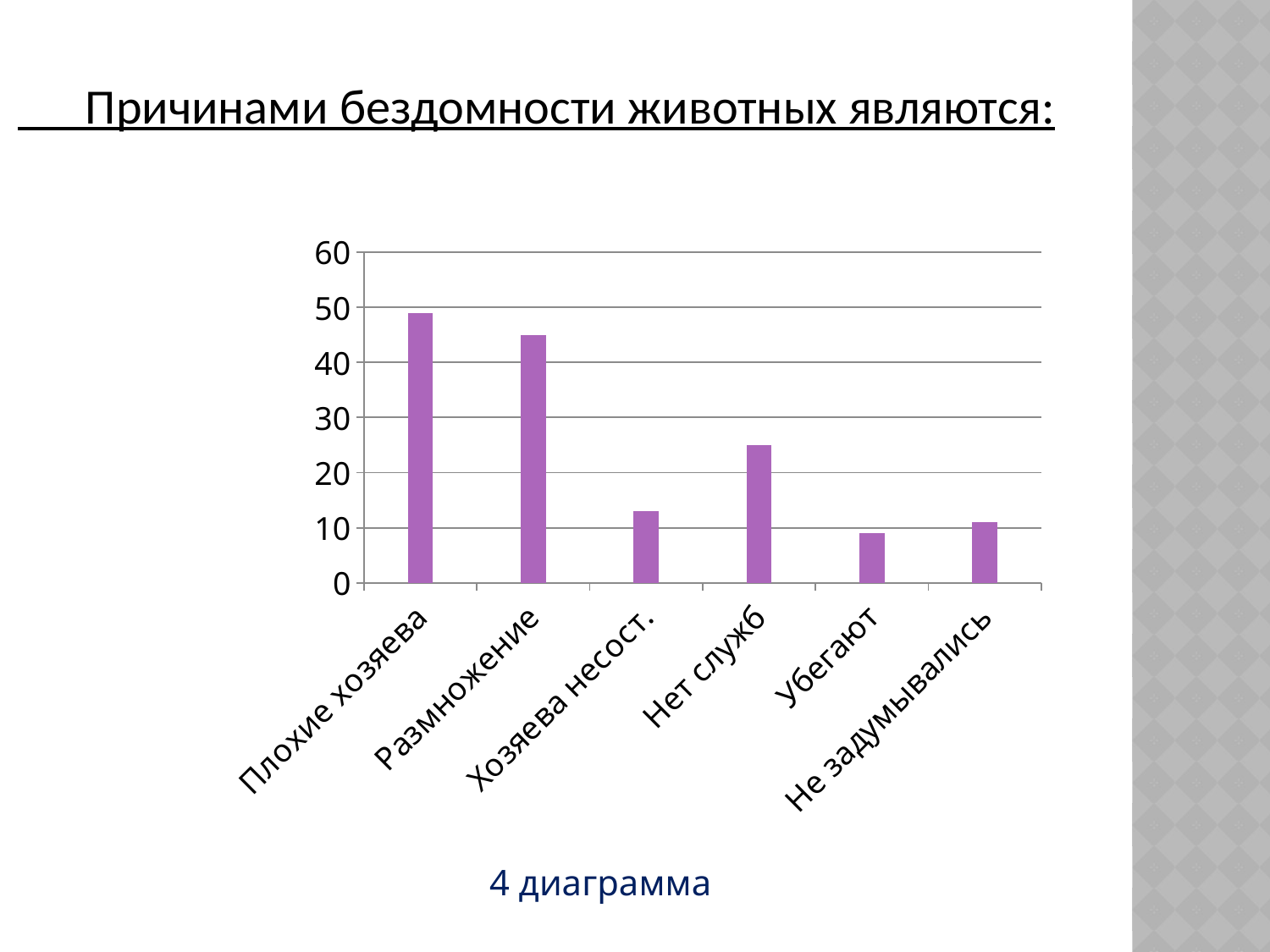
What kind of chart is shown on the slide? bar chart Which is larger, the value for Нет служб or the value for Хозяева несост.? Нет служб Is the value for Не задумывались greater or less than 20? less Is the value for Размножение greater or less than 50? less Is the value for Нет служб greater or less than 20? greater What caption is written below the chart? 4 диаграмма Which is larger, the value for Размножение or the value for Нет служб? Размножение Which category has the highest bar in the chart? Плохие хозяева How many categories are shown on the x axis of the chart? 6 Which category has the lowest bar in the chart? Убегают